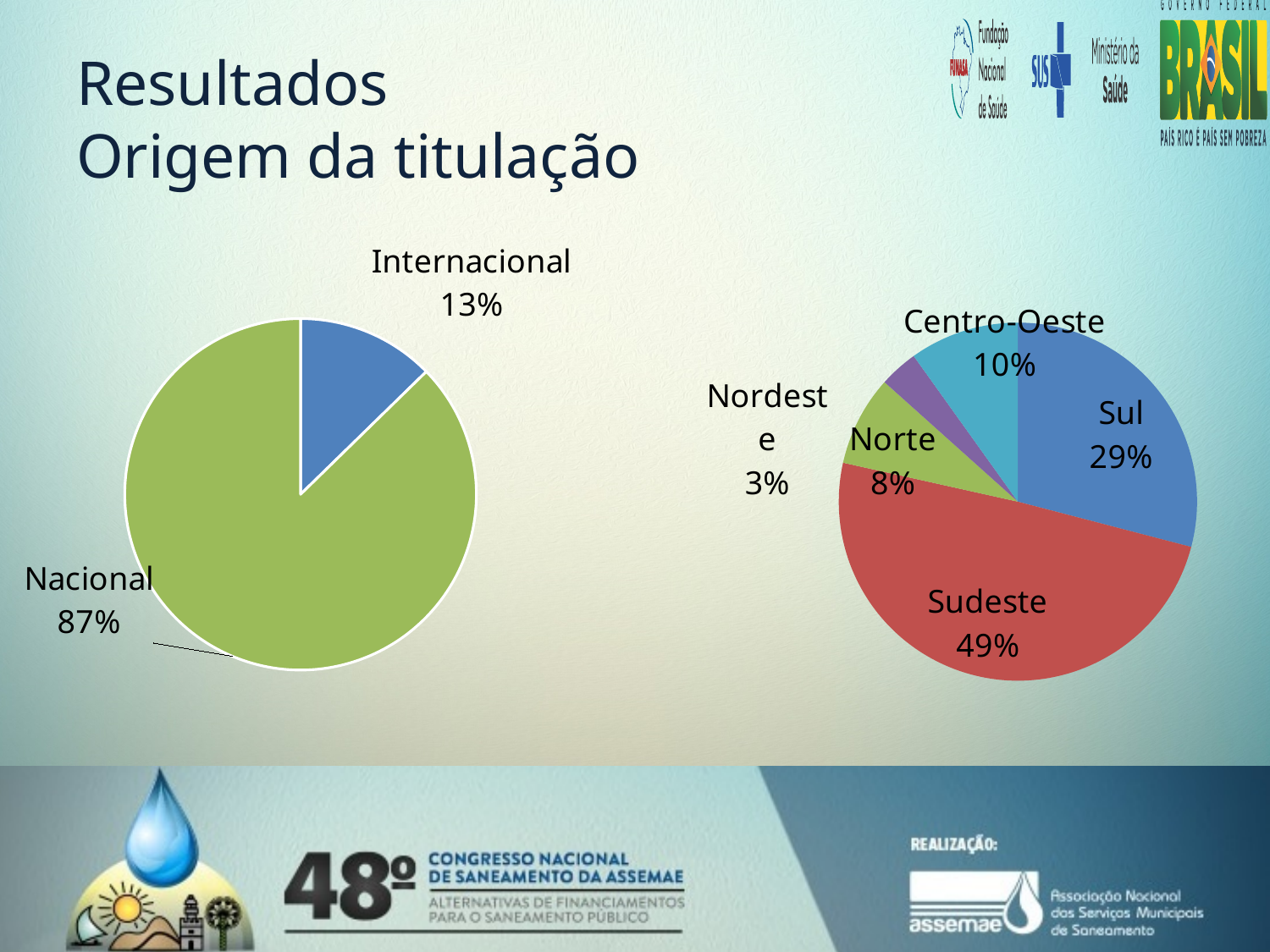
On the right pie chart, what share is labelled Nordeste? 3% On the right pie chart, what share is labelled Sudeste? 49% On the left pie chart, what share is labelled Nacional? 87% What type of chart is shown on the left of the slide? Pie chart On the right pie chart, which is larger, Norte or Centro-Oeste? Centro-Oeste How many slices does the right pie chart have? 5 On the right pie chart, what share is labelled Centro-Oeste? 10% On the right pie chart, what is the difference in percentage points between Sudeste and Sul? 20 On the right pie chart, which region has the smallest slice? Nordeste On the right pie chart, which region has the largest slice? Sudeste On the left pie chart, what is the difference in percentage points between Nacional and Internacional? 74 On the left pie chart, what share is labelled Internacional? 13%